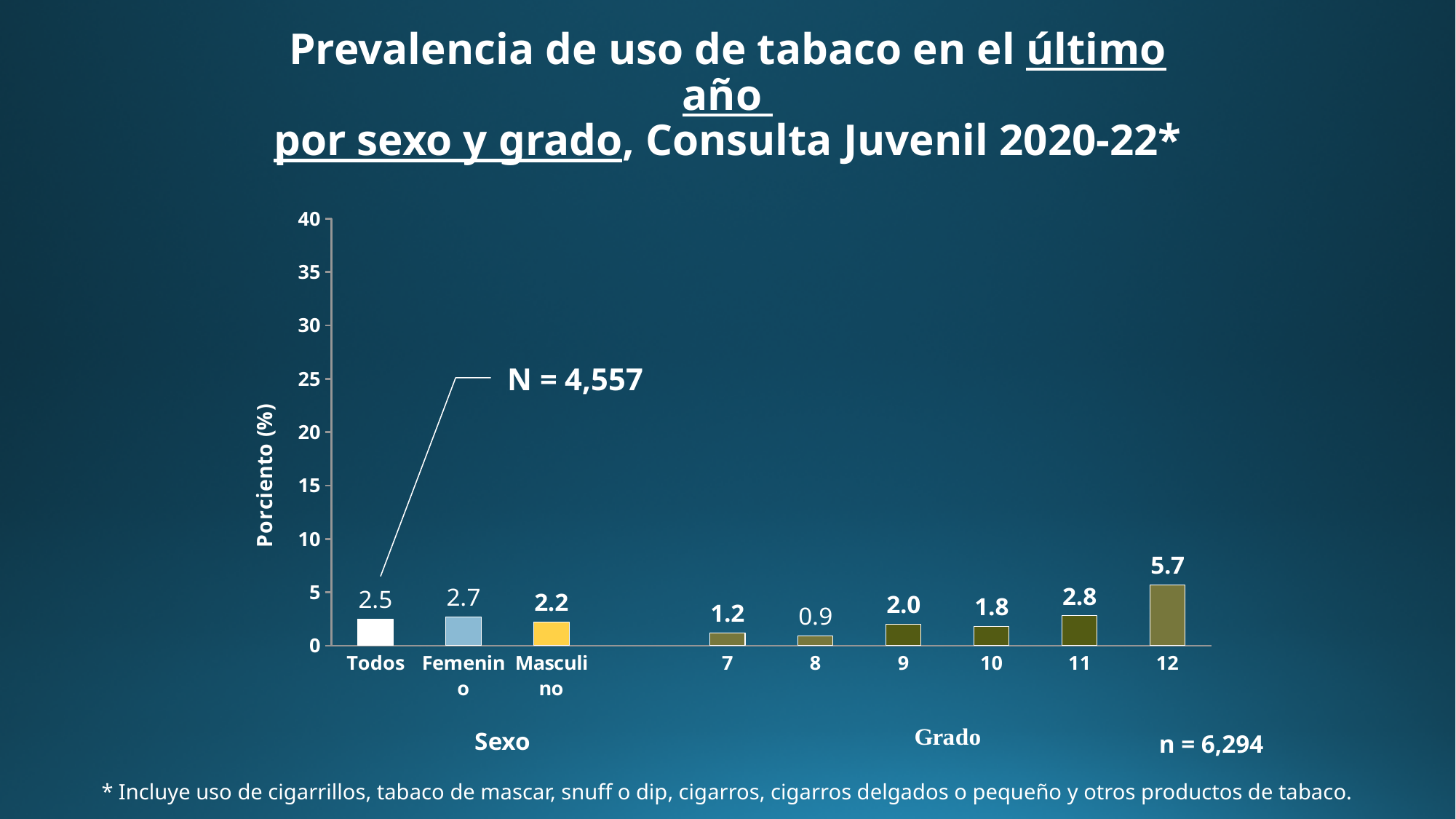
What is the value for grade 8? 0.9 What is the value for grade 12? 5.7 How many bars are plotted on the chart? 9 What is the value for Femenino? 2.7 What kind of chart is shown? bar chart Which is larger, the value for Femenino or the value for Masculino? Femenino Which category has the highest value? 12 Which category has the lowest value? 8 What is the label of the vertical axis? Porciento (%) What is the value for Todos? 2.5 What is the difference between the values for grade 12 and grade 11? 2.9 Is the value for grade 12 greater or less than 5? greater